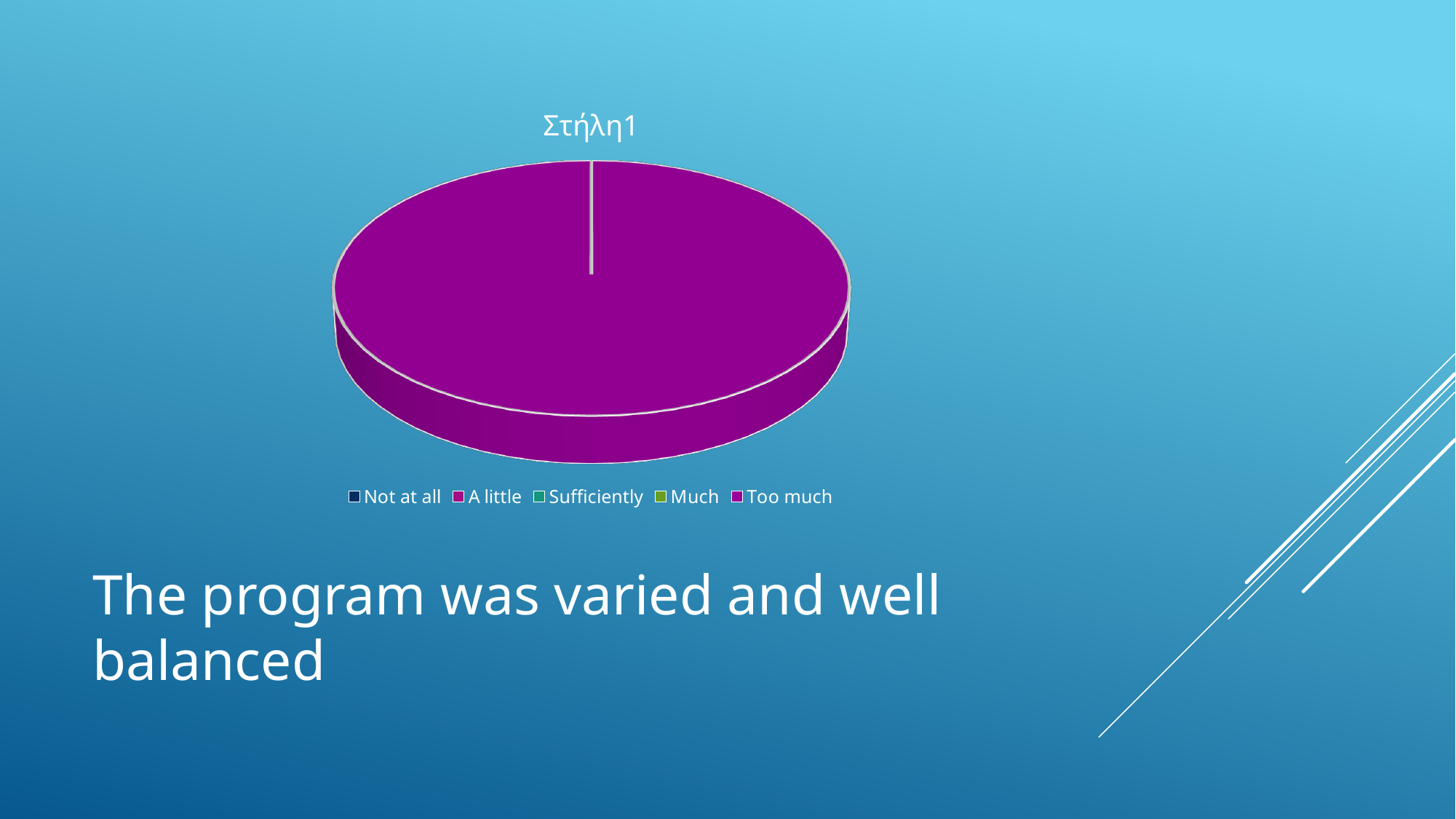
Is the slice for Too much larger than the slice for Not at all? Yes What kind of chart is shown on the slide? pie chart What is the title of the chart? Στήλη1 Which category is listed first in the legend? Not at all Which category has the largest slice of the pie? Too much Which of the two categories, Too much or Sufficiently, has the larger slice? Too much How many data series does the chart plot? 1 How many categories does the chart's legend list? 5